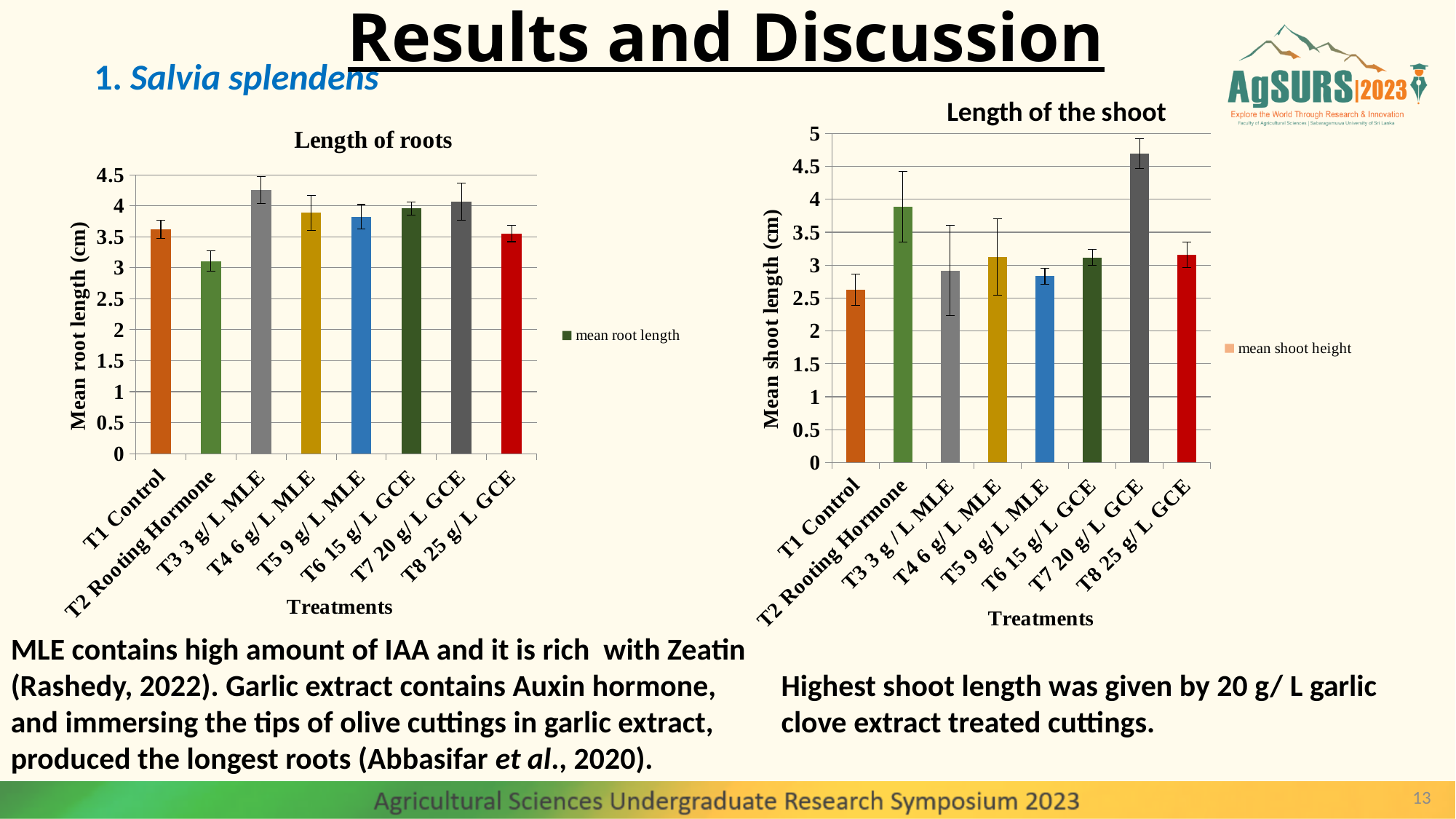
What is the y-axis label of the "Length of the shoot" chart? Mean shoot length (cm) How many treatments are shown on the x axis of the "Length of the shoot" chart? 8 In the "Length of the shoot" chart, which treatment has the highest mean shoot length? T7 20 g/L GCE In the "Length of roots" chart, is the value for T3 3 g/L MLE greater or less than 4? greater In the "Length of roots" chart, which treatment has the lowest mean root length? T2 Rooting Hormone How many series does the legend of the "Length of roots" chart list? 1 In the "Length of roots" chart, is the value for T2 Rooting Hormone greater or less than 3.5? less In the "Length of roots" chart, which treatment has the highest mean root length? T3 3 g/L MLE In the "Length of the shoot" chart, is the value for T1 Control greater or less than 3? less In the "Length of the shoot" chart, which is larger, the value for T7 20 g/L GCE or T2 Rooting Hormone? T7 20 g/L GCE What kind of chart is the "Length of roots" chart? bar chart